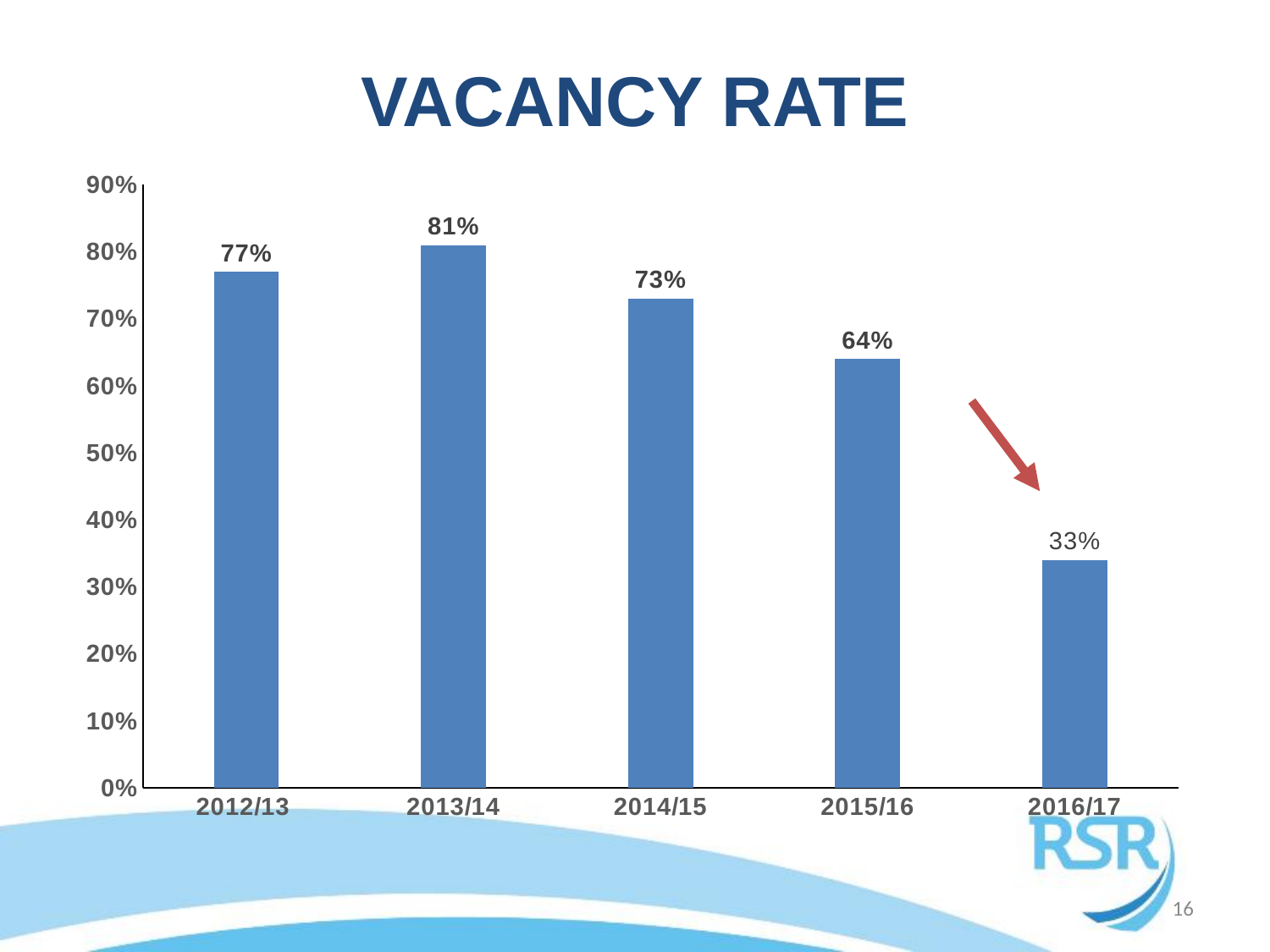
Which year has the highest vacancy rate? 2013/14 Does the vacancy rate rise or fall from 2013/14 to 2016/17? fall What is the vacancy rate for 2013/14? 81% What is the difference between the vacancy rate in 2013/14 and 2014/15? 8% Which year has the lowest vacancy rate? 2016/17 How many years are shown on the chart? 5 What kind of chart is shown on the slide? bar chart What is the difference between the vacancy rate in 2015/16 and 2016/17? 31% What is the vacancy rate for 2015/16? 64% Which year has a higher vacancy rate, 2012/13 or 2014/15? 2012/13 What is the vacancy rate for 2016/17? 33% Is the vacancy rate for 2015/16 greater or less than 70%? less